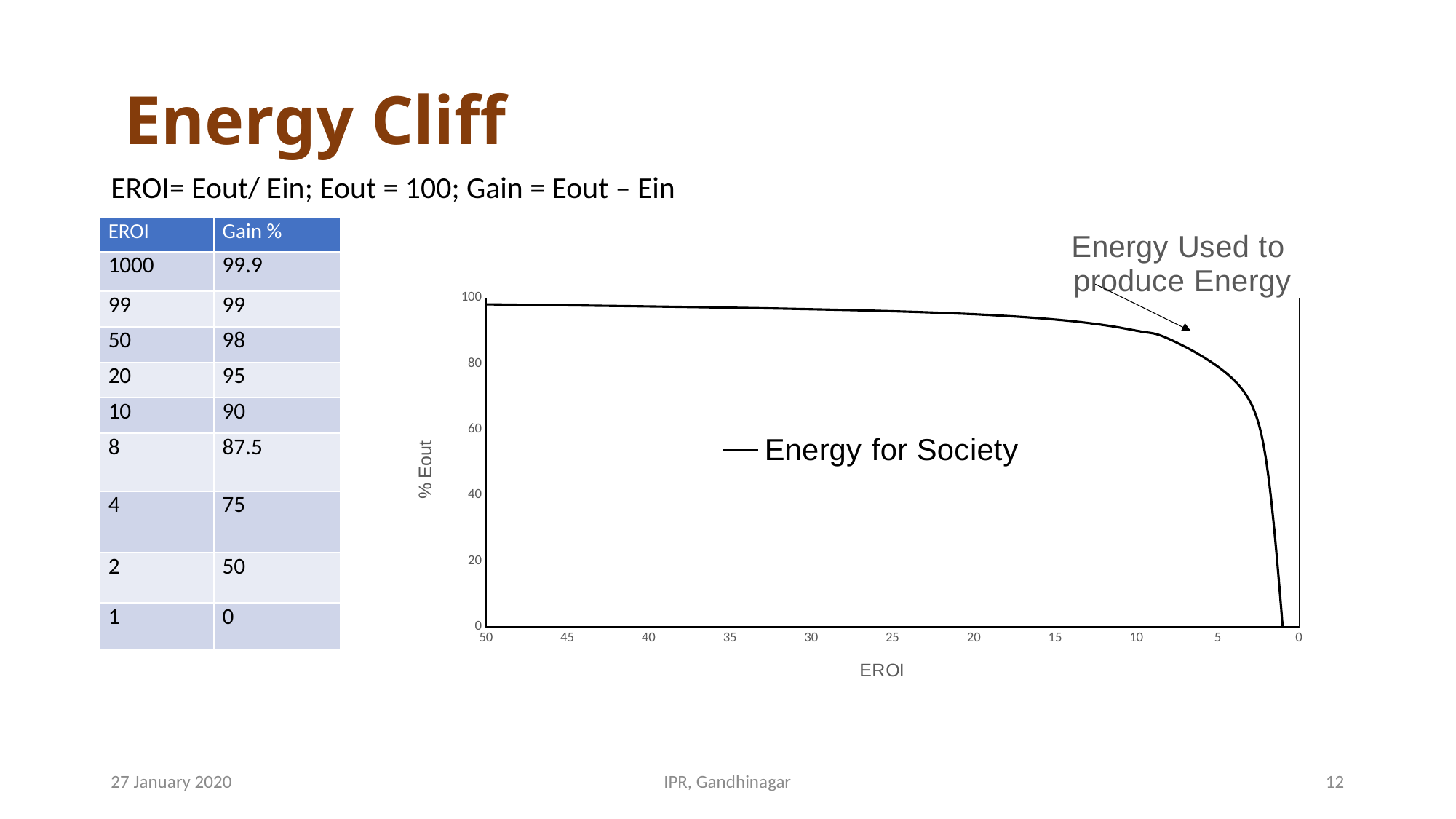
Moving from left to right along the x axis, does the Energy for Society line rise or fall? fall Is the value of Energy for Society at EROI 25 greater or less than 60? greater What is the name of the series shown in the chart's legend? Energy for Society Is the value of Energy for Society at EROI 10 greater or less than 80? greater What is the title of the chart's x axis? EROI Is the value of Energy for Society at EROI 50 greater or less than 80? greater How many series does the chart's legend list? 1 Which is larger, the value of Energy for Society at EROI 40 or at EROI 2? EROI 40 What kind of chart is shown on the slide? line chart